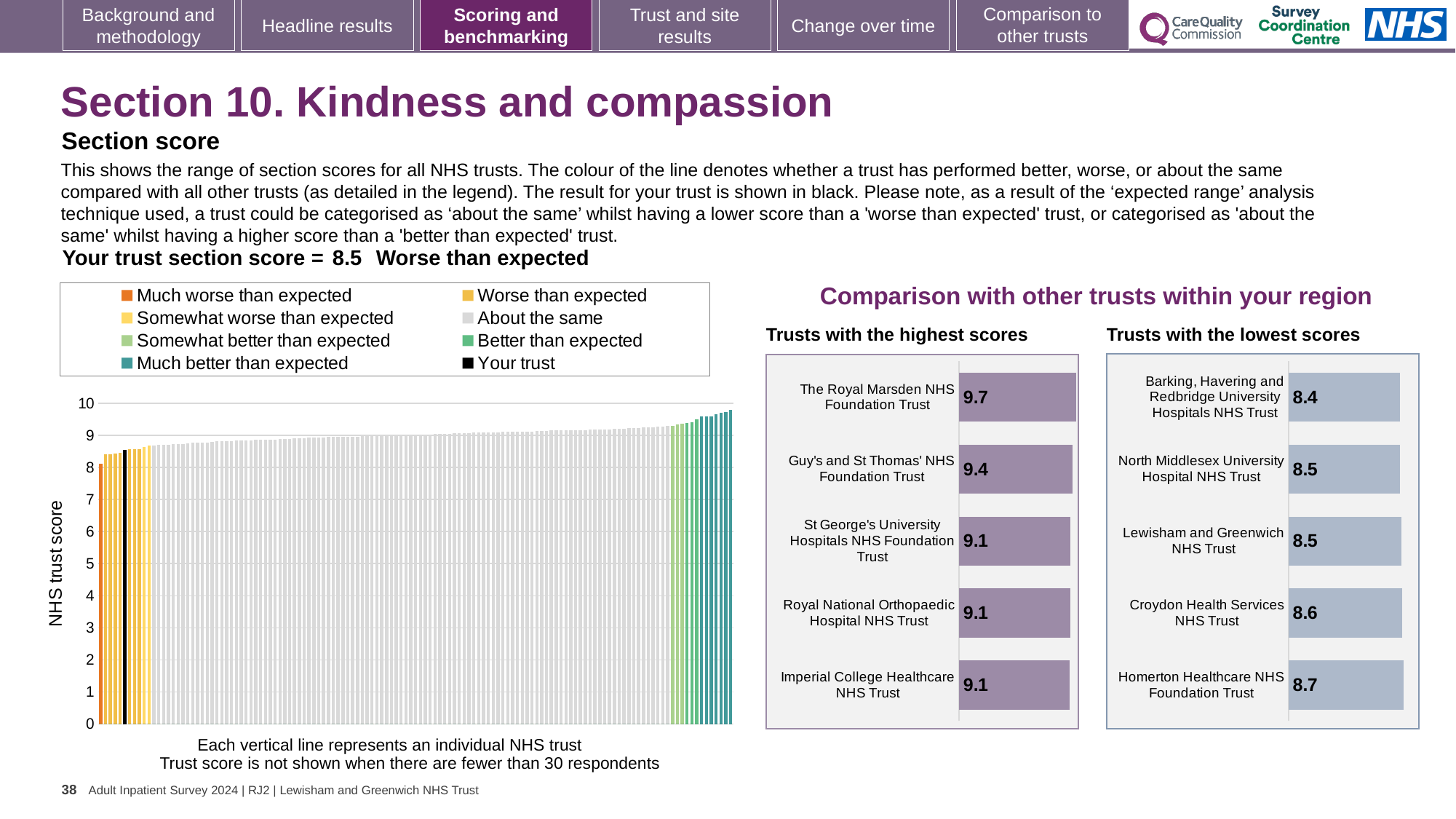
In the 'Trusts with the lowest scores' chart, what is the score for Barking, Havering and Redbridge University Hospitals NHS Trust? 8.4 In the 'Trusts with the lowest scores' chart, what is the score for Homerton Healthcare NHS Foundation Trust? 8.7 In the NHS trust score chart on the left, how many entries does the legend list? 8 In the 'Trusts with the highest scores' chart, what is the difference between the scores of The Royal Marsden NHS Foundation Trust and Guy's and St Thomas' NHS Foundation Trust? 0.3 In the 'Trusts with the lowest scores' chart, which trust has the lowest score? Barking, Havering and Redbridge University Hospitals NHS Trust In the 'Trusts with the highest scores' chart, how many trusts are shown? 5 In the 'Trusts with the highest scores' chart, which trust has the highest score? The Royal Marsden NHS Foundation Trust In the 'Trusts with the highest scores' chart, what is the score for Guy's and St Thomas' NHS Foundation Trust? 9.4 In the 'Trusts with the highest scores' chart, what is the score for The Royal Marsden NHS Foundation Trust? 9.7 In the 'Trusts with the lowest scores' chart, what is the difference between the scores of Homerton Healthcare NHS Foundation Trust and Barking, Havering and Redbridge University Hospitals NHS Trust? 0.3 In the NHS trust score chart on the left, do the trust scores rise or fall from left to right along the x axis? rise In the 'Trusts with the lowest scores' chart, which is larger: the score for Croydon Health Services NHS Trust or North Middlesex University Hospital NHS Trust? Croydon Health Services NHS Trust